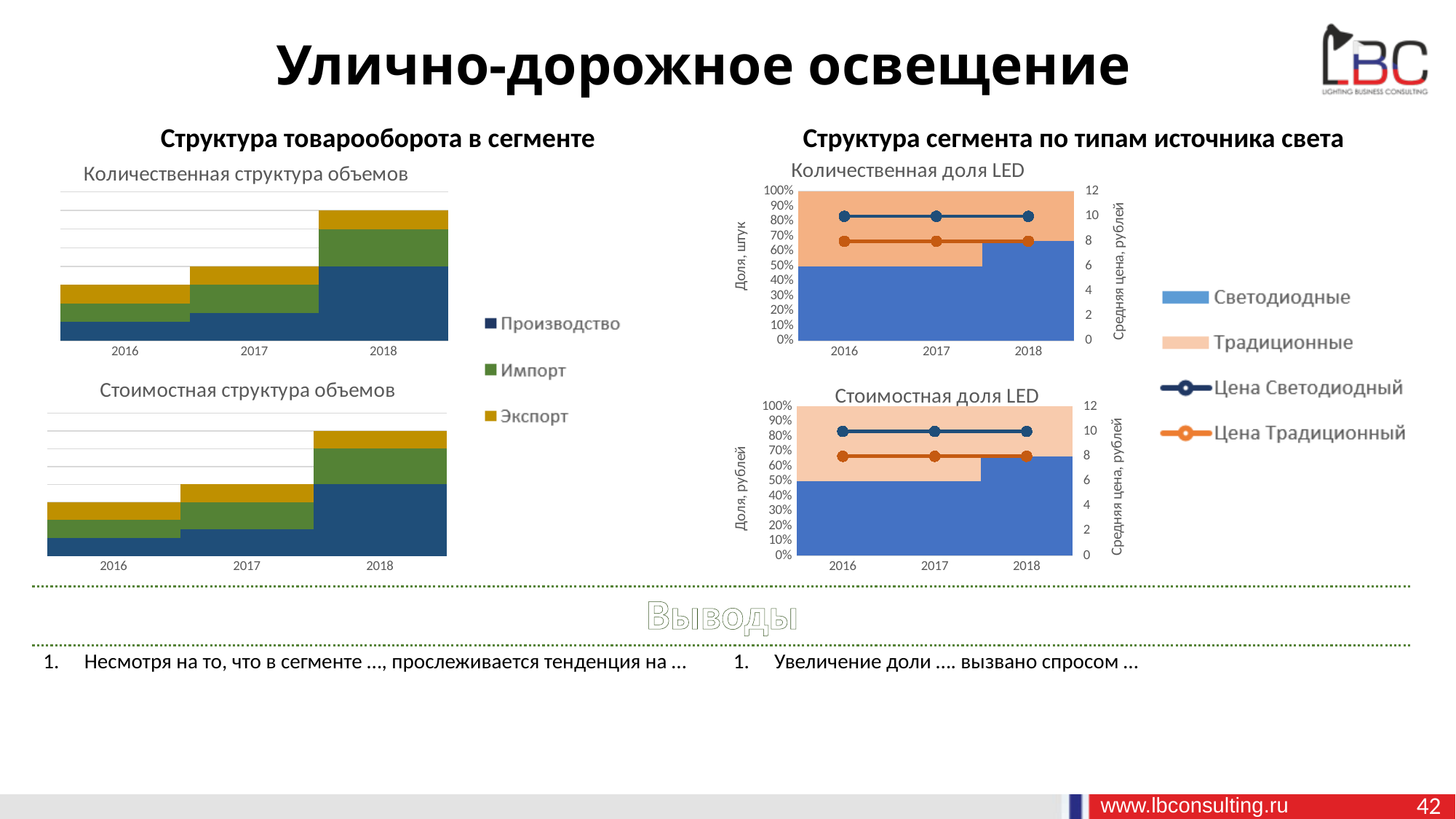
In "Количественная доля LED", is the Светодиодные share in 2018 greater or less than 70%? less How many entries does the legend of "Структура сегмента по типам источника света" list? 4 How many years are shown on the x axis of "Стоимостная структура объемов"? 3 What colour represents Производство in the left charts? Dark blue In "Количественная структура объемов", does the total bar height rise or fall from 2016 to 2018? Rise How many series does the legend of "Структура товарооборота в сегменте" list? 3 In "Количественная доля LED", which line is higher: Цена Светодиодный or Цена Традиционный? Цена Светодиодный In "Количественная доля LED", what is the value of Цена Светодиодный in 2018 on the right axis? 10 In "Стоимостная доля LED", does the Светодиодные share rise or fall from 2017 to 2018? Rise What kind of chart is "Количественная структура объемов"? Stacked bar chart In "Количественная доля LED", is the Светодиодные share in 2016 greater or less than 60%? less In "Стоимостная доля LED", what is the value of Цена Традиционный in 2016 on the right axis? 8